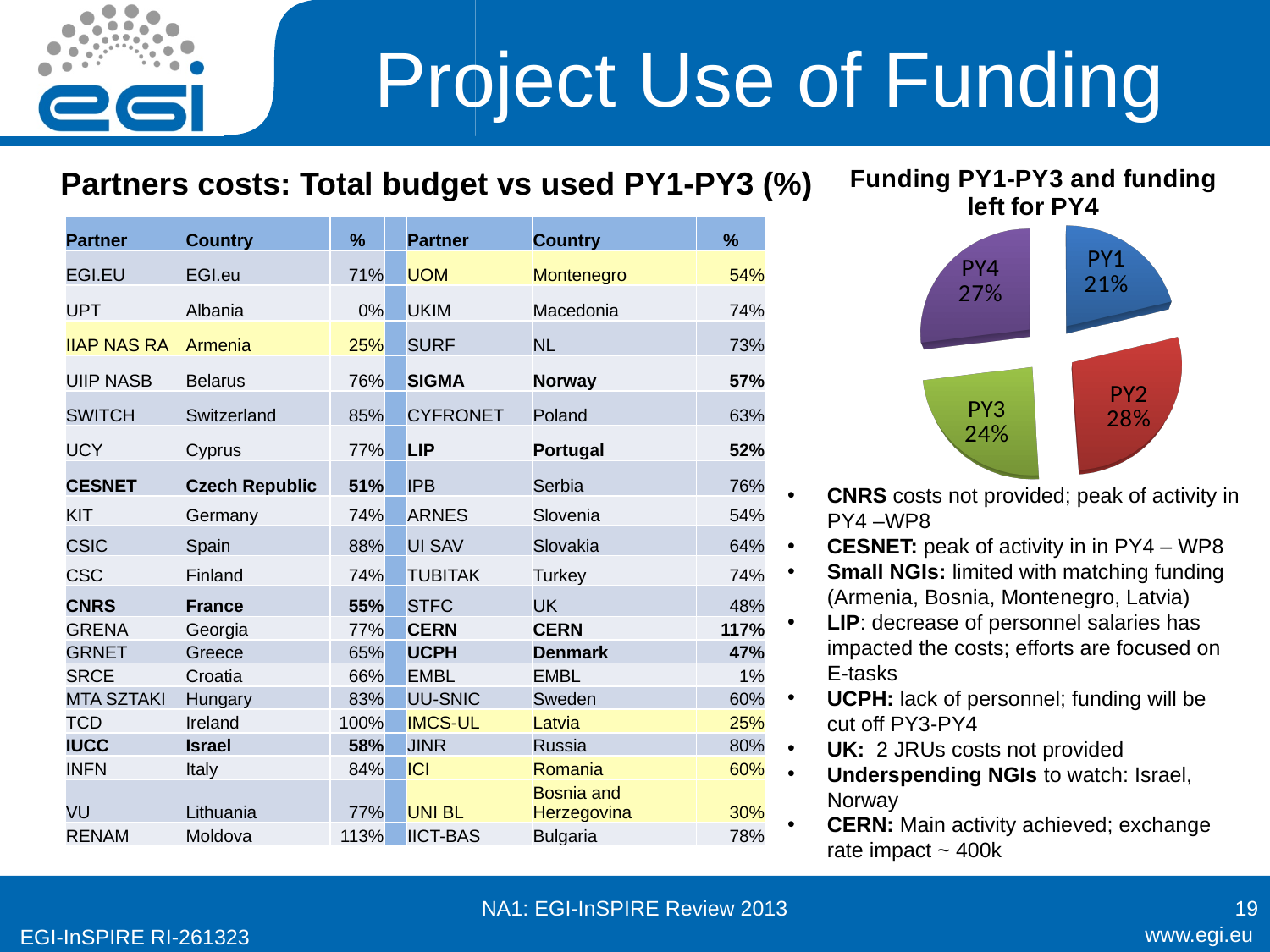
In the pie chart, which is larger, the PY3 share or the PY4 share? PY4 In the pie chart, what share is shown for PY4? 27% Which slice of the pie chart is the smallest? PY1 How many slices does the pie chart have? 4 In the pie chart, what is the difference between the PY2 and PY1 shares? 7% What kind of chart is shown under the title 'Funding PY1-PY3 and funding left for PY4'? pie chart In the pie chart, what colour is the PY2 slice? red Which slice of the pie chart is the largest? PY2 In the pie chart, what share is shown for PY2? 28% In the pie chart, what share is shown for PY3? 24% What is the title of the pie chart? Funding PY1-PY3 and funding left for PY4 In the pie chart, what share is shown for PY1? 21%